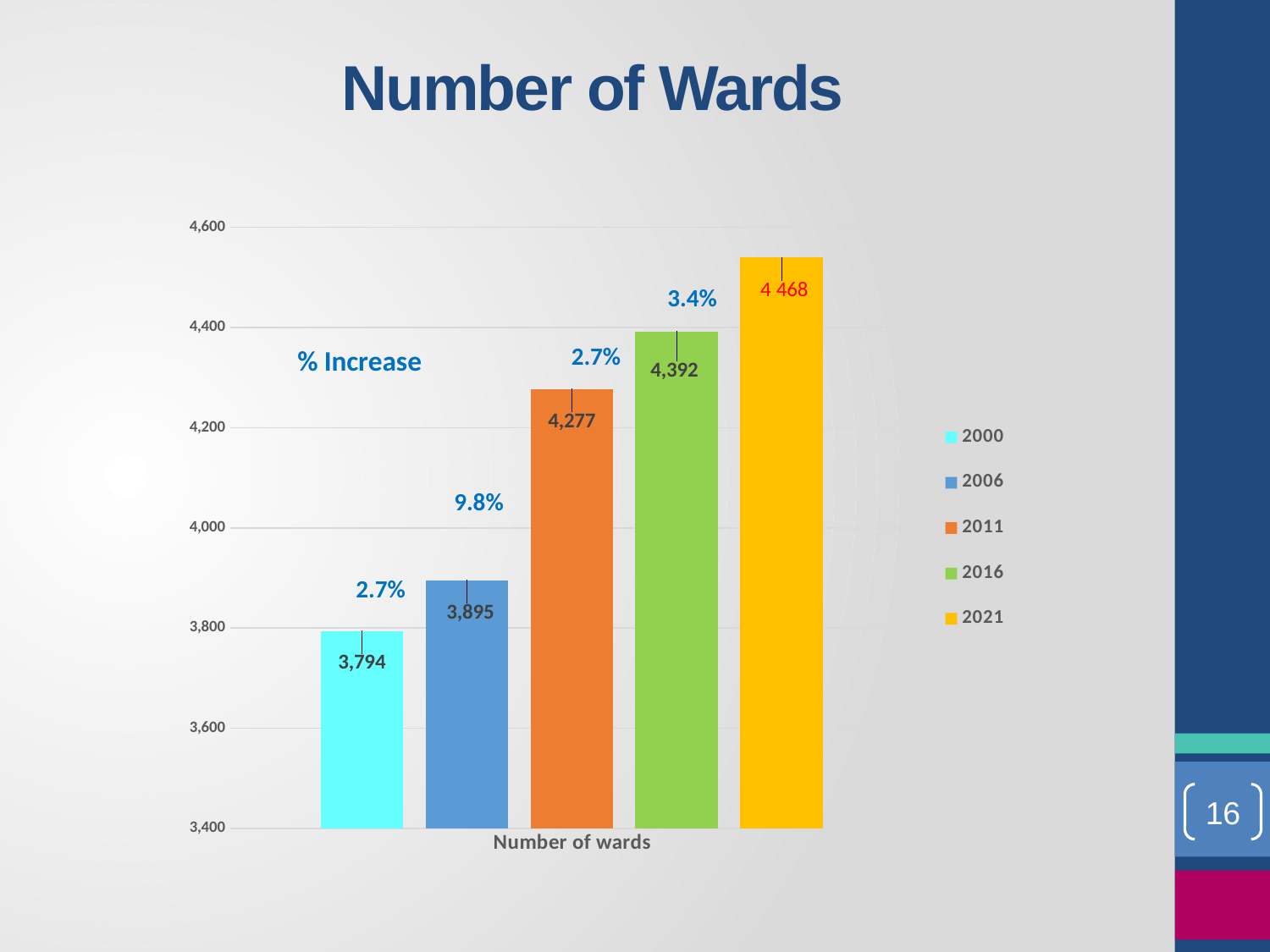
What is the number of wards for 2000? 3,794 How many series does the legend list? 5 What percentage increase is shown above the 2006 bar? 9.8% What is the number of wards for 2006? 3,895 What is the difference in the number of wards between 2016 and 2011? 115 What is the number of wards for 2011? 4,277 What is the difference in the number of wards between 2006 and 2000? 101 What value is labelled on the 2021 bar? 4 468 Which year has the highest number of wards? 2021 Which is larger, the number of wards in 2011 or in 2006? 2011 Which year has the lowest number of wards? 2000 What is the number of wards for 2016? 4,392